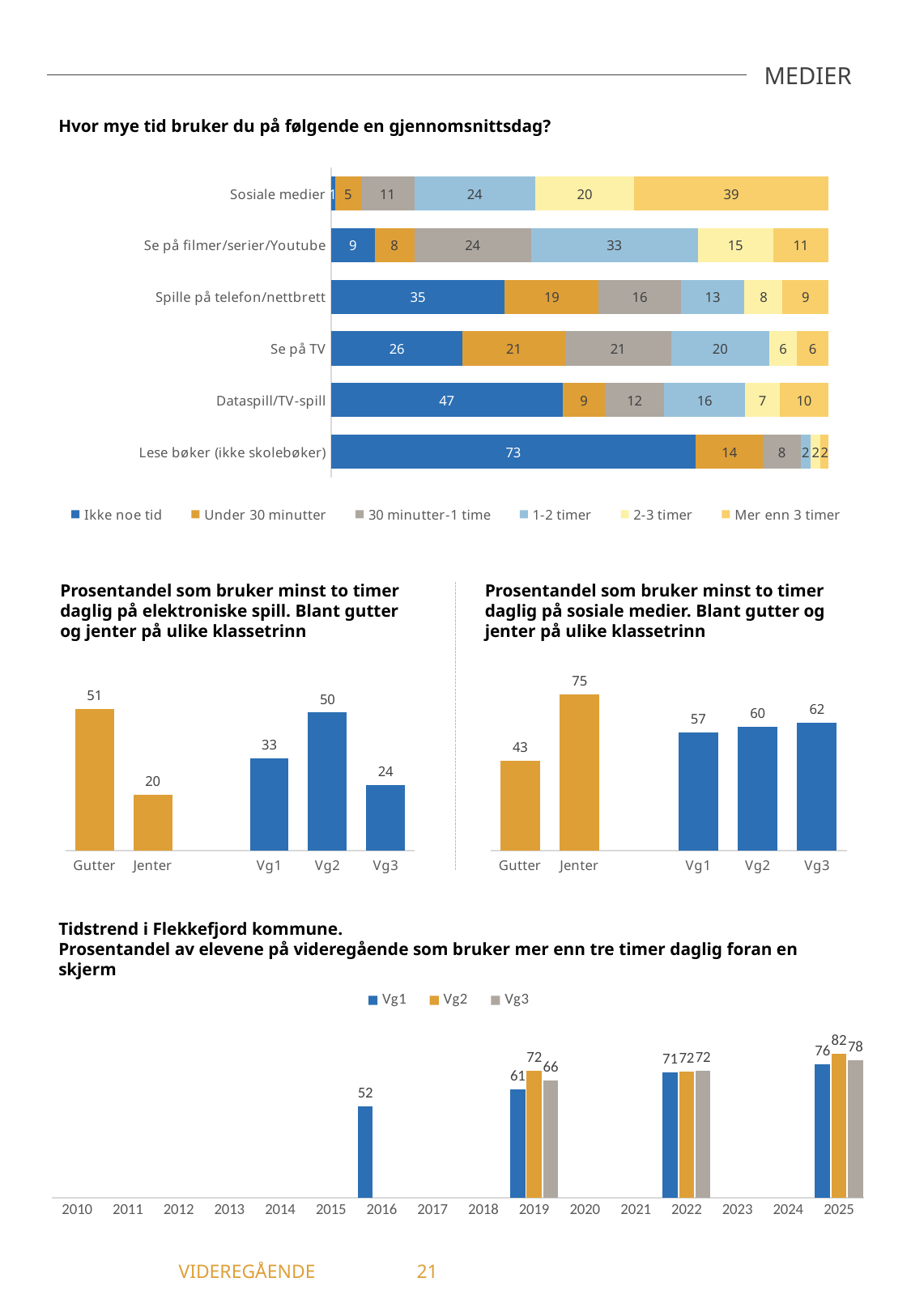
In the chart 'Tidstrend i Flekkefjord kommune', what kind of chart is it? bar chart In the chart 'Prosentandel som bruker minst to timer daglig på elektroniske spill', what is the value for Gutter? 51 In the chart 'Hvor mye tid bruker du på følgende en gjennomsnittsdag?', which activity has the highest value for 'Ikke noe tid'? Lese bøker (ikke skolebøker) In the chart 'Prosentandel som bruker minst to timer daglig på sosiale medier', what is the value for Jenter? 75 In the chart 'Prosentandel som bruker minst to timer daglig på elektroniske spill', which category has the lowest value? Jenter In the chart 'Prosentandel som bruker minst to timer daglig på sosiale medier', do the values rise or fall from Vg1 to Vg3? rise In the chart 'Hvor mye tid bruker du på følgende en gjennomsnittsdag?', what is the value for 'Mer enn 3 timer' for Sosiale medier? 39 In the chart 'Tidstrend i Flekkefjord kommune', what is the value for Vg2 in 2025? 82 In the chart 'Hvor mye tid bruker du på følgende en gjennomsnittsdag?', what is the difference between the 'Ikke noe tid' values for Dataspill/TV-spill and Se på TV? 21 In the chart 'Hvor mye tid bruker du på følgende en gjennomsnittsdag?', what is the value for 'Ikke noe tid' for Lese bøker (ikke skolebøker)? 73 In the chart 'Hvor mye tid bruker du på følgende en gjennomsnittsdag?', how many series does the legend list? 6 In the chart 'Prosentandel som bruker minst to timer daglig på sosiale medier', what is the difference between Jenter and Gutter? 32